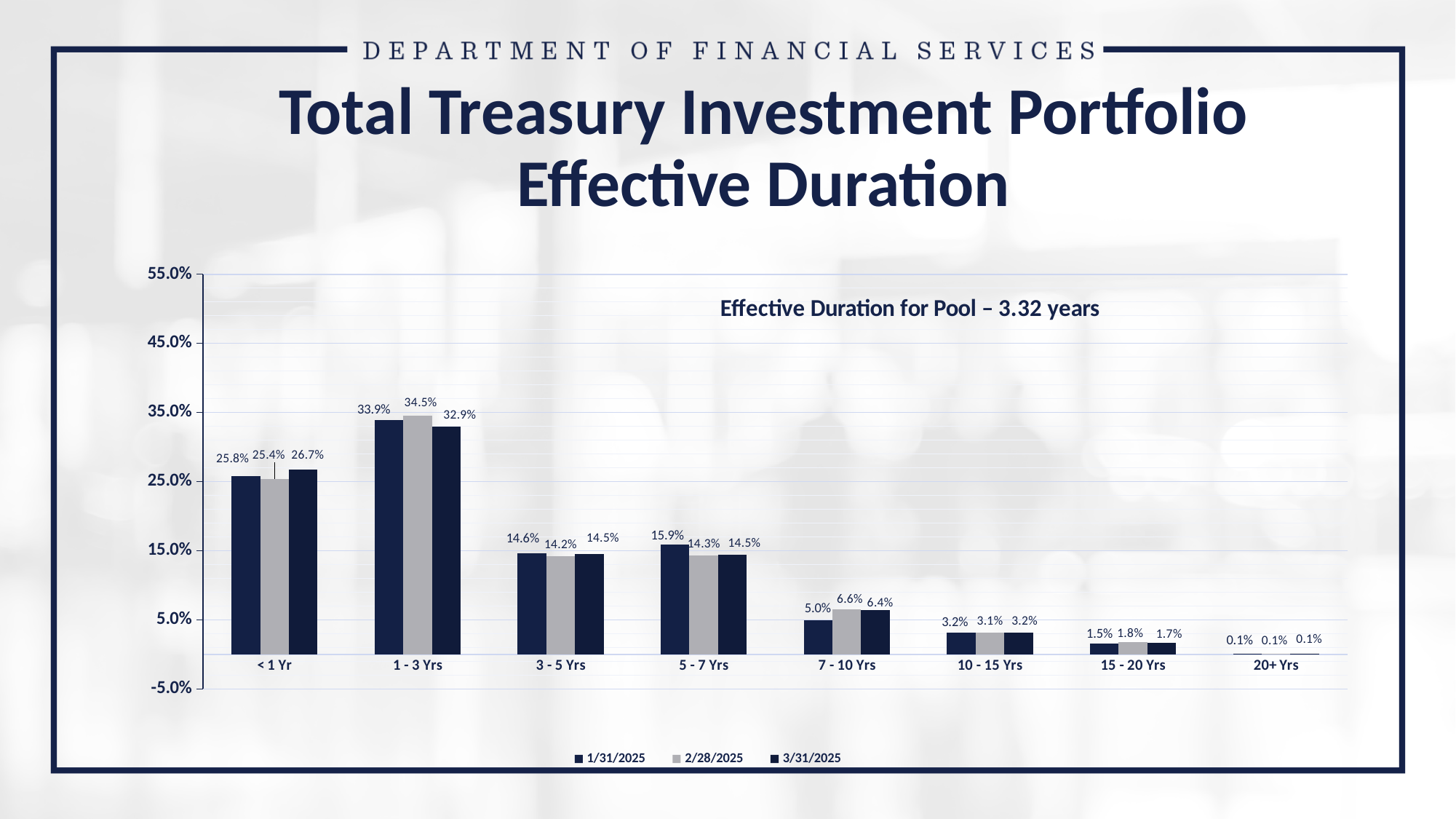
What is the value for the 7 - 10 Yrs category in the 1/31/2025 series? 5.0% How many duration categories are shown on the x axis? 8 What kind of chart is shown on the slide? Bar chart What is the value for the < 1 Yr category in the 3/31/2025 series? 26.7% Which category has the lowest value in the 1/31/2025 series? 20+ Yrs How many series does the legend list? 3 Which is larger for the 7 - 10 Yrs category: the 2/28/2025 value or the 1/31/2025 value? 2/28/2025 What is the difference between the 1/31/2025 and 2/28/2025 values for the 5 - 7 Yrs category? 1.6% Which category has the highest value in the 3/31/2025 series? 1 - 3 Yrs What is the value for the 1 - 3 Yrs category in the 2/28/2025 series? 34.5% What effective duration for the pool is stated on the chart? 3.32 years Is the 2/28/2025 value for the 1 - 3 Yrs category greater or less than 25.0%? greater